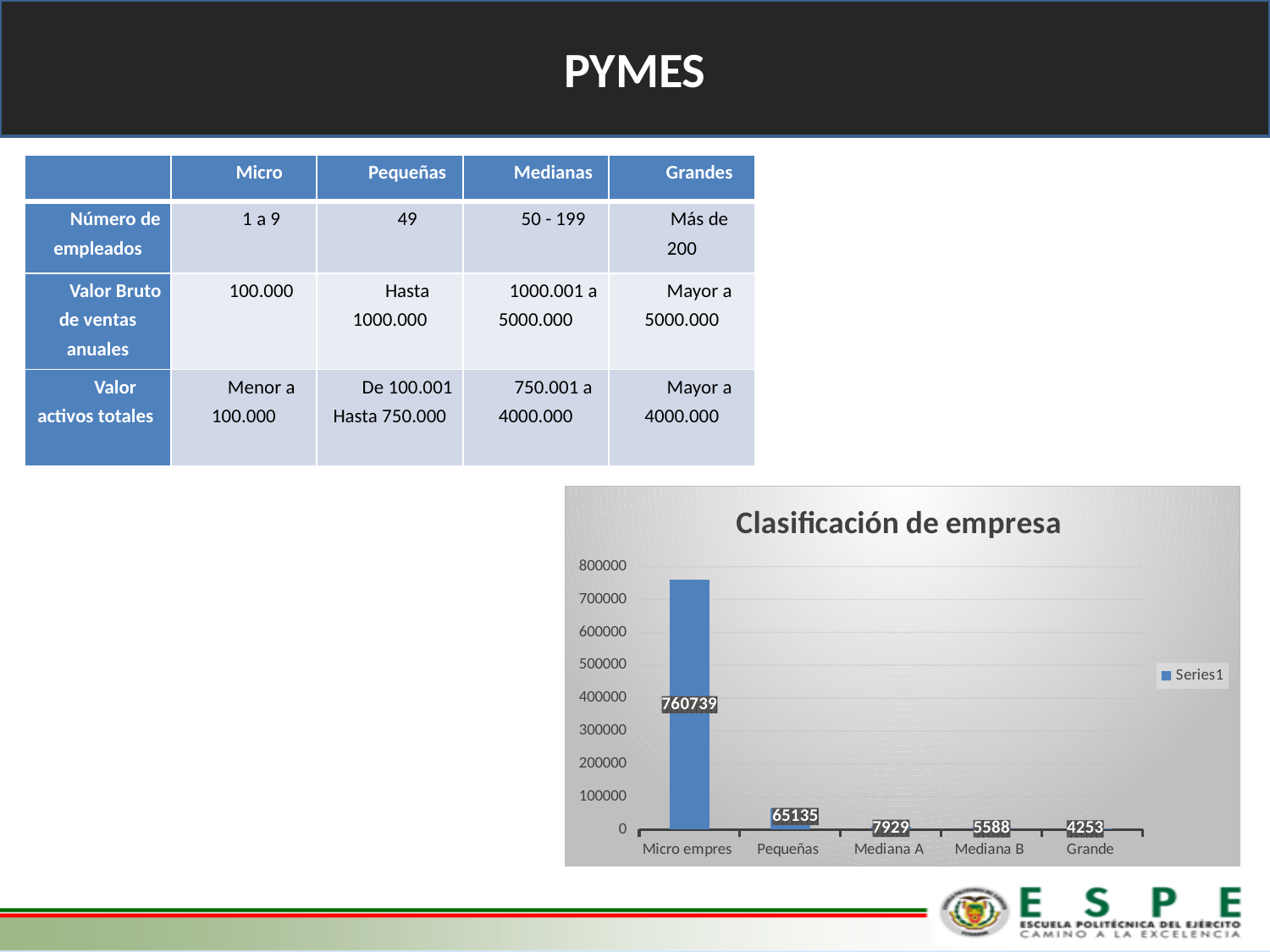
How many categories are shown in the Clasificación de empresa chart? 5 Is the value for Micro empres in the Clasificación de empresa chart greater or less than 700000? greater What is the value for Mediana A in the Clasificación de empresa chart? 7929 What is the difference between the values for Micro empres and Pequeñas in the Clasificación de empresa chart? 695604 What is the value for Grande in the Clasificación de empresa chart? 4253 Which category has the lowest value in the Clasificación de empresa chart? Grande What is the legend entry shown in the Clasificación de empresa chart? Series1 What kind of chart is the Clasificación de empresa chart? bar chart Which category has the highest value in the Clasificación de empresa chart? Micro empres Which is larger in the Clasificación de empresa chart, Mediana A or Mediana B? Mediana A What is the value for Pequeñas in the Clasificación de empresa chart? 65135 What is the value for Micro empres in the Clasificación de empresa chart? 760739